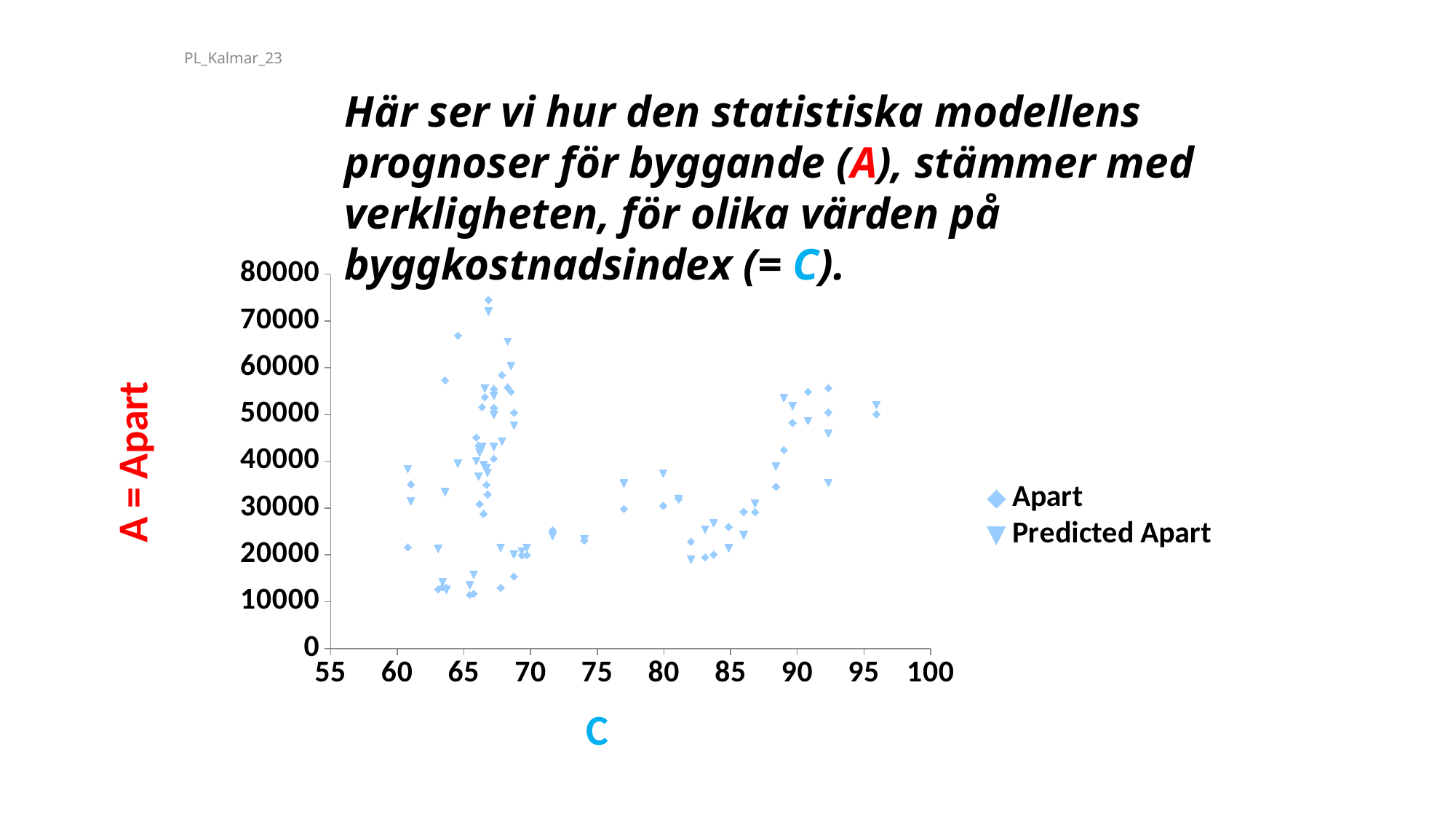
Is the lowest plotted value on the chart greater or less than 20000? less How many series does the legend list? 2 Is the highest plotted value on the chart greater or less than 80000? less Is the highest plotted value on the chart greater or less than 70000? greater What kind of chart is shown on the slide? Scatter chart What is the label on the vertical axis of the chart? A = Apart What are the two series named in the legend? Apart and Predicted Apart